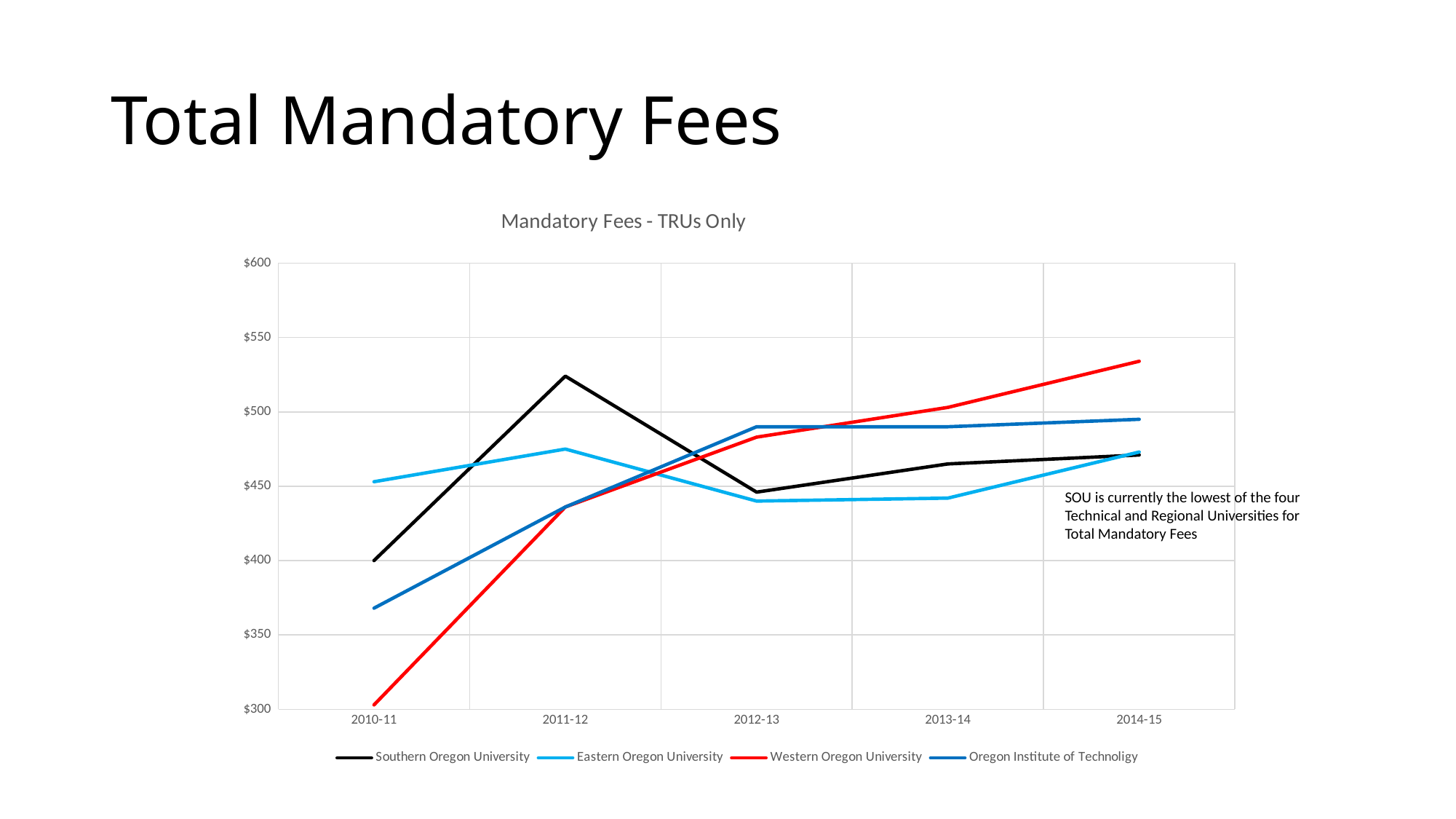
Which university has the highest mandatory fees in 2011-12? Southern Oregon University What is the title of the chart? Mandatory Fees - TRUs Only How many academic years are plotted along the x axis? 5 What kind of chart is shown on the slide? Line chart Which university has the highest mandatory fees in 2014-15? Western Oregon University Which university has the lowest mandatory fees in 2010-11? Western Oregon University Is the value for Southern Oregon University in 2011-12 greater or less than $500? greater Is the value for Oregon Institute of Technoligy in 2010-11 greater or less than $400? less In 2011-12, which is larger: the value for Southern Oregon University or Eastern Oregon University? Southern Oregon University Is the value for Western Oregon University in 2010-11 greater or less than $350? less Do the values for Western Oregon University rise or fall from 2010-11 to 2014-15? rise How many series does the legend list? 4